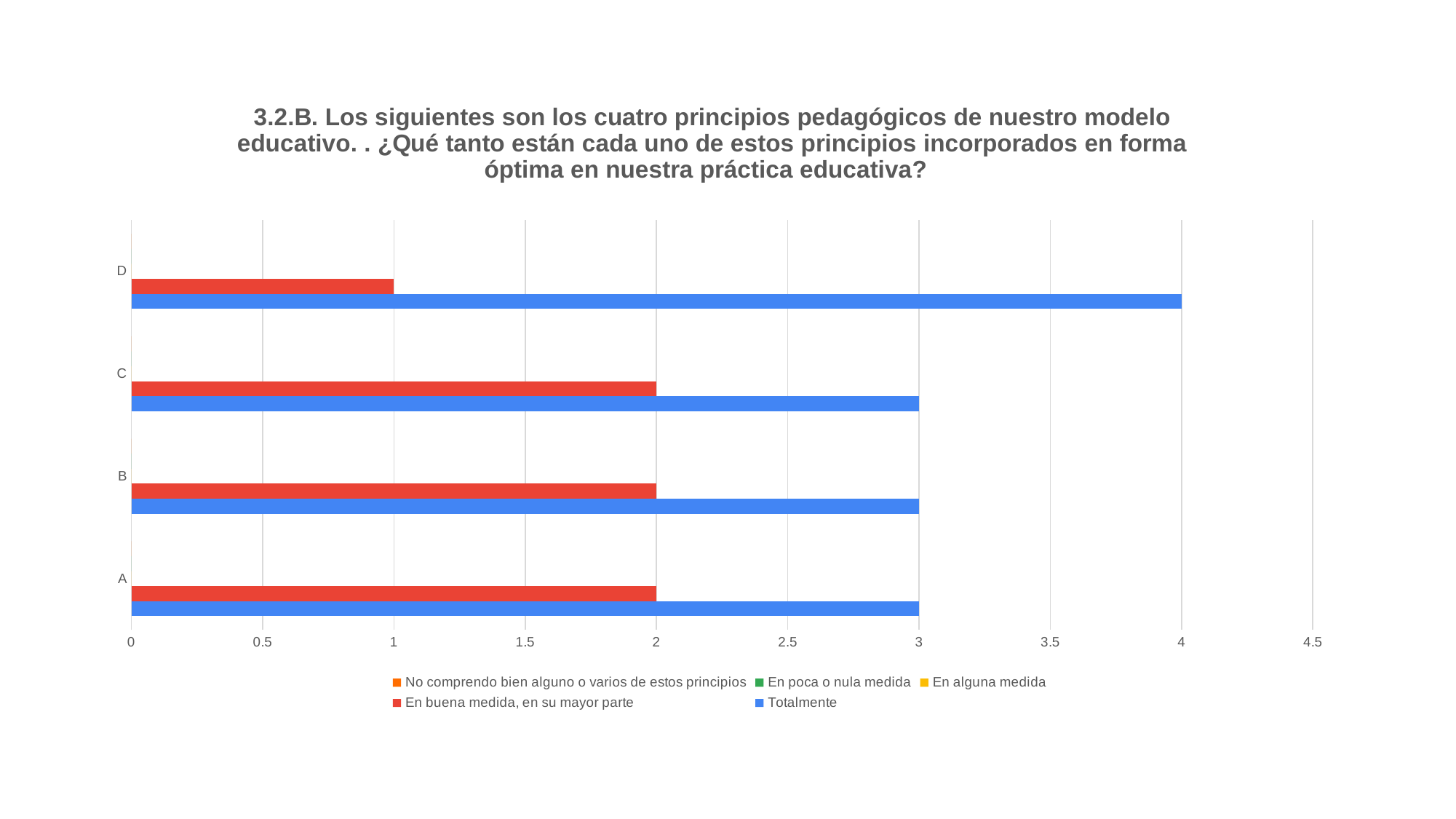
What kind of chart is shown on the slide? bar chart How many series does the legend list? 5 For category C, which is larger: the 'Totalmente' value or the 'En buena medida, en su mayor parte' value? Totalmente What colour represents the 'Totalmente' series in the legend? blue What is the value of the 'Totalmente' series for category A? 3 What is the value of the 'En buena medida, en su mayor parte' series for category D? 1 Which category has the highest value for the 'Totalmente' series? D What is the value of the 'En buena medida, en su mayor parte' series for category B? 2 What is the difference between the 'Totalmente' value and the 'En buena medida, en su mayor parte' value for category D? 3 What is the value of the 'Totalmente' series for category D? 4 Which category has the lowest value for the 'En buena medida, en su mayor parte' series? D How many categories are shown on the vertical axis? 4